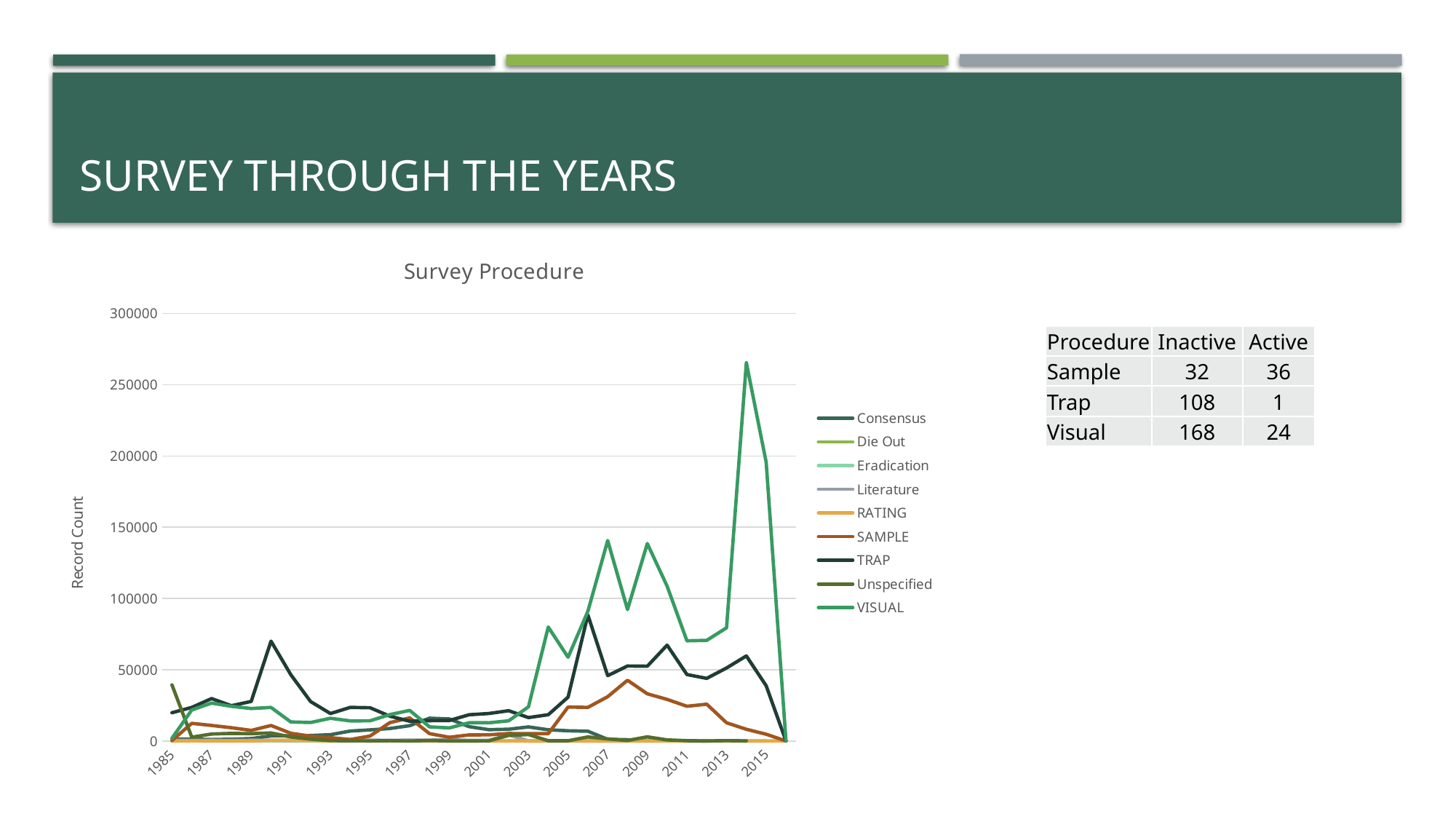
Is the peak value of the VISUAL series around 2014 greater or less than 250000? greater What kind of chart is shown on the slide? line chart Is the value of the VISUAL series in 2007 greater or less than 100000? greater Is the value of the SAMPLE series in 2009 greater or less than 50000? less In 2013, which series has the larger value, VISUAL or TRAP? VISUAL What is the title of the chart on the slide? Survey Procedure How many year labels are shown on the x axis of the chart? 16 Around 1990, which series has the larger value, TRAP or SAMPLE? TRAP Which series reaches the highest value anywhere on the chart? VISUAL How many series does the legend of the Survey Procedure chart list? 9 What is the label on the vertical axis of the chart? Record Count